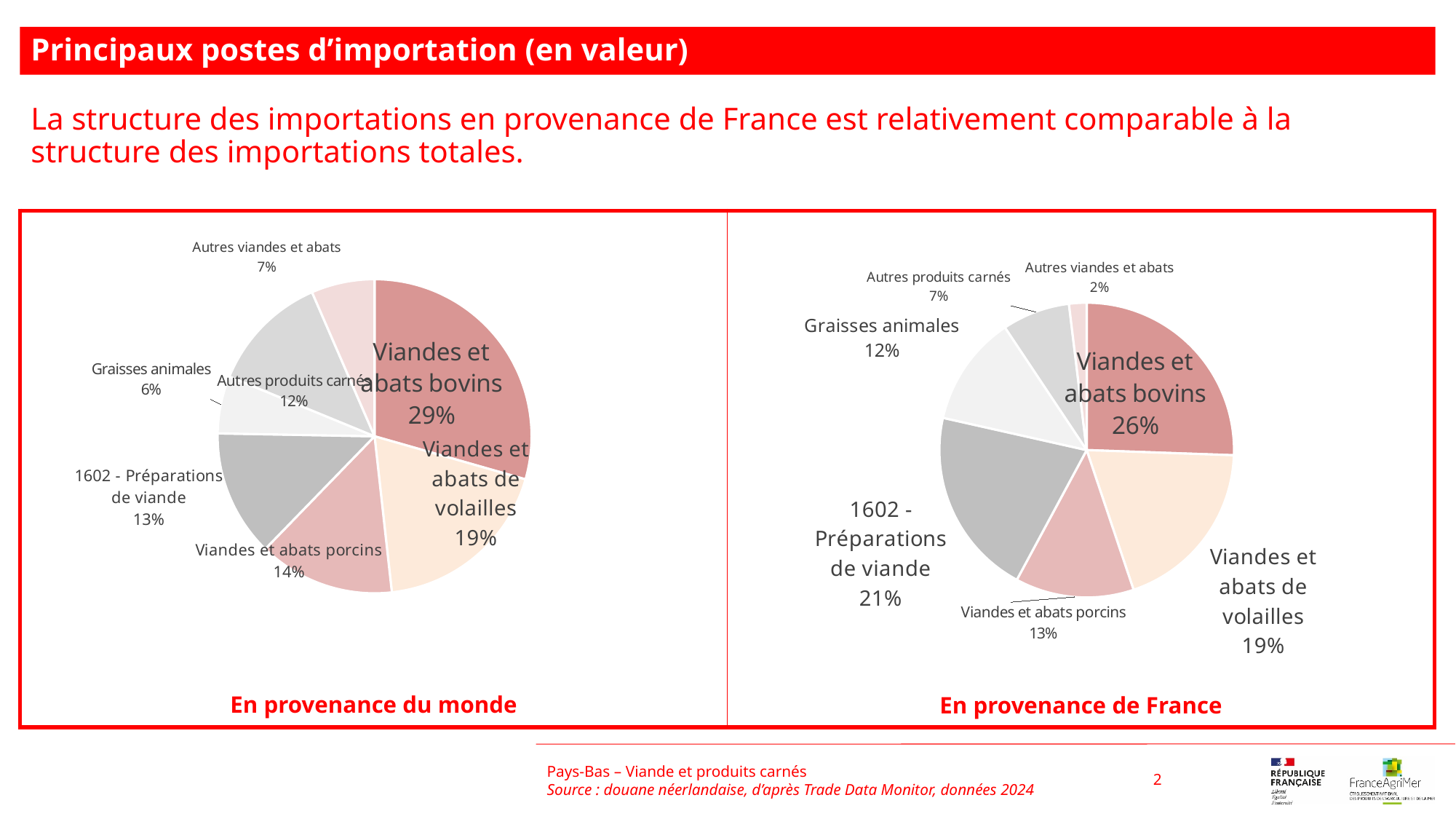
In the 'En provenance de France' pie chart, which category has the smallest share? Autres viandes et abats In the 'En provenance du monde' pie chart, which category has the smallest share? Graisses animales In the 'En provenance du monde' pie chart, which is larger: Viandes et abats porcins or 1602 - Préparations de viande? Viandes et abats porcins What is the title of the chart on the right side of the slide? En provenance de France In the 'En provenance du monde' pie chart, what share is shown for Viandes et abats bovins? 29% In the 'En provenance de France' pie chart, what share is shown for 1602 - Préparations de viande? 21% How many categories are shown in the 'En provenance de France' pie chart? 7 In the 'En provenance de France' pie chart, what is the difference between the shares of 1602 - Préparations de viande and Viandes et abats porcins? 8 percentage points In the 'En provenance du monde' pie chart, which category has the largest share? Viandes et abats bovins What type of chart is used on the left side of the slide ('En provenance du monde')? Pie chart In the 'En provenance de France' pie chart, what share is shown for Graisses animales? 12% What is the difference between the share of Viandes et abats bovins in the 'En provenance du monde' chart and in the 'En provenance de France' chart? 3 percentage points